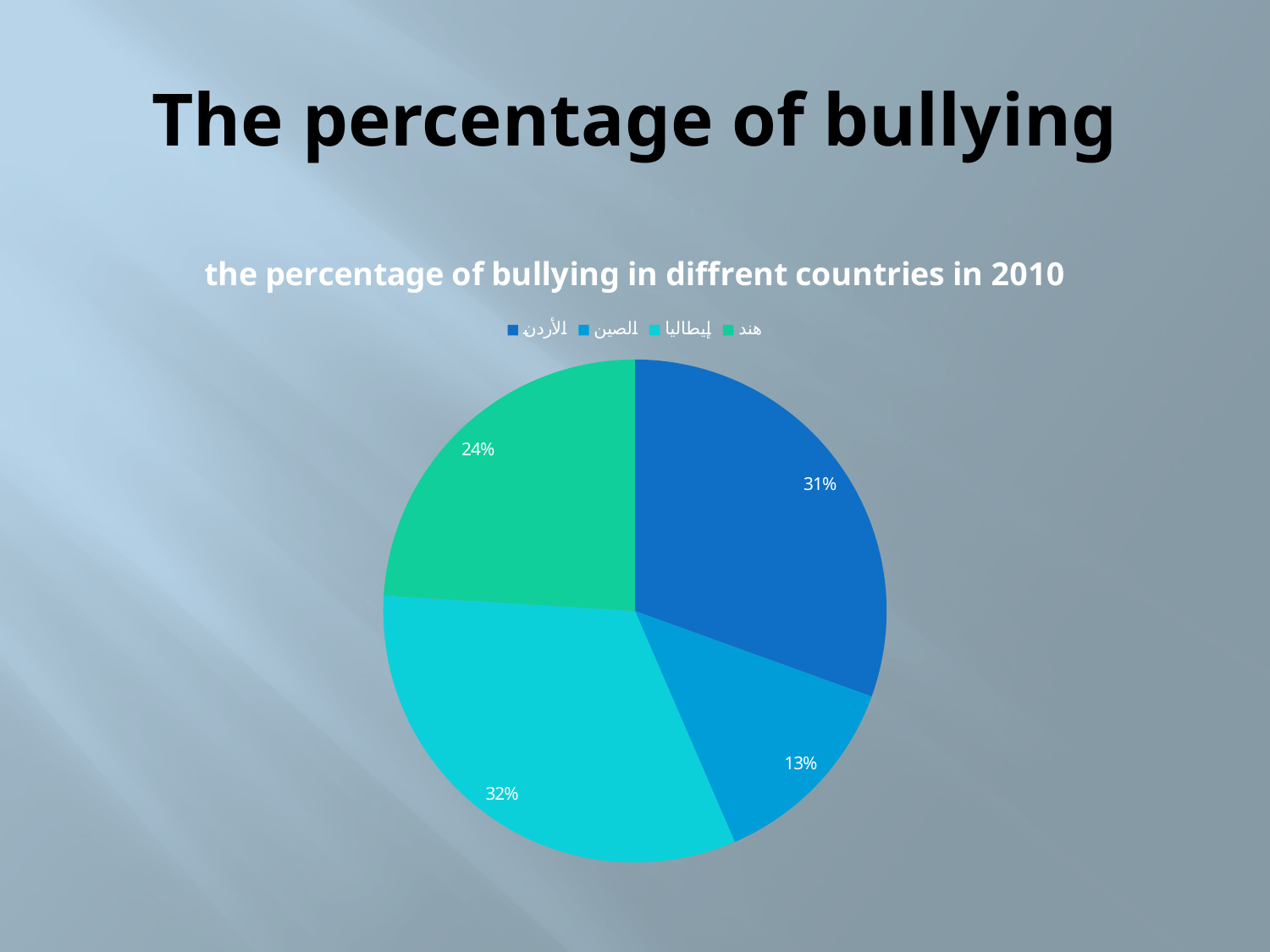
What percentage is shown for the cyan slice (إيطاليا)? 32% Which slice has the largest share of the pie? إيطاليا (32%) What kind of chart is shown on the slide? pie chart How many slices does the pie chart have? 4 What percentage is shown for the green slice (هند)? 24% What is the title of the chart? the percentage of bullying in diffrent countries in 2010 Which is larger, the share for هند or the share for الصين? هند How many entries does the legend list? 4 Which slice has the smallest share of the pie? الصين (13%) What percentage is shown for the medium blue slice (الصين)? 13% What is the difference between the share for الأردن and the share for الصين? 18% What percentage is shown for the dark blue slice (الأردن)? 31%